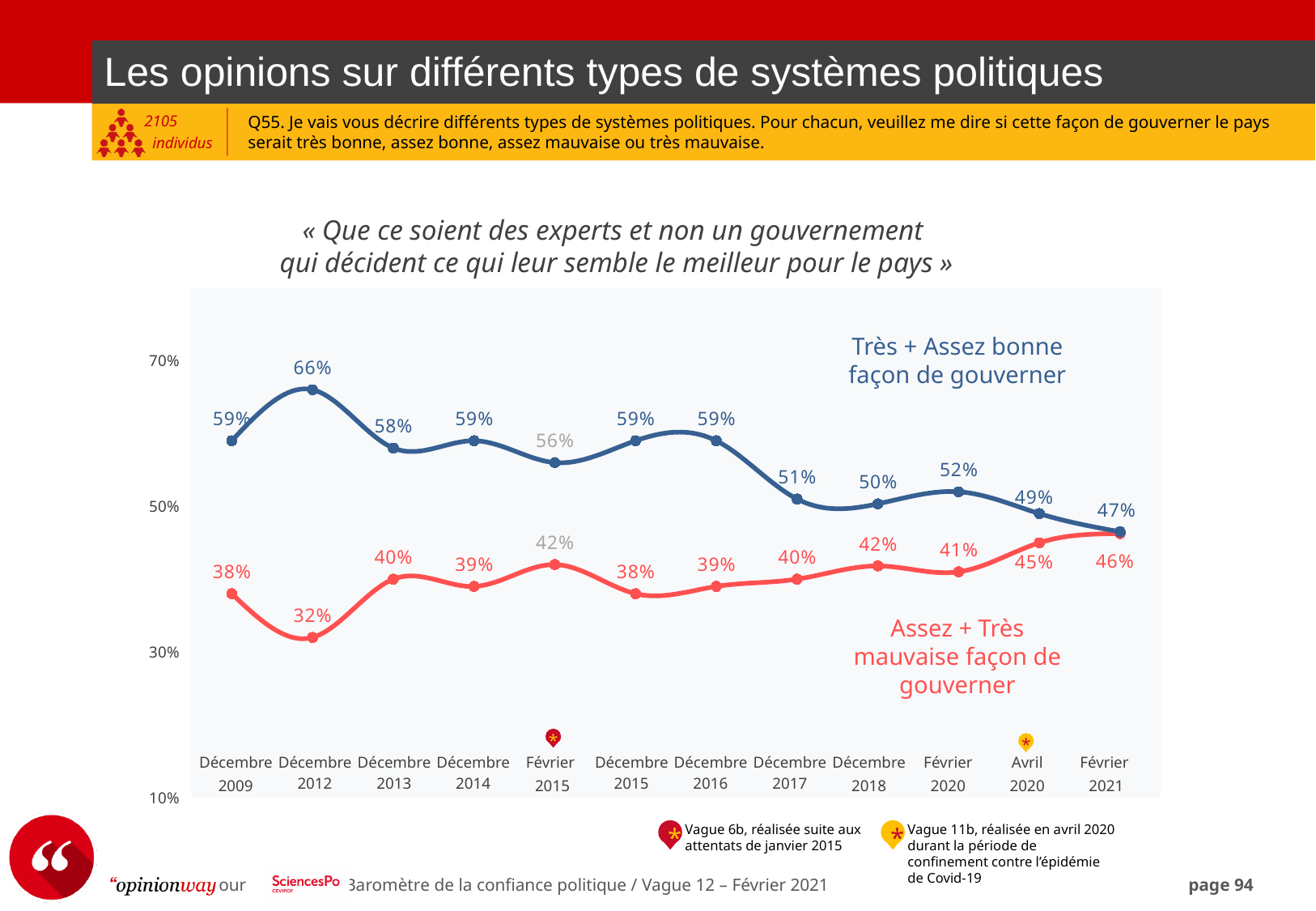
How many series are plotted on the chart? 2 In which period does the 'Assez + Très mauvaise façon de gouverner' series reach its lowest value? Décembre 2012 Which is larger in Avril 2020: the 'Très + Assez bonne' value or the 'Assez + Très mauvaise' value? Très + Assez bonne (49%) In which period does the 'Très + Assez bonne façon de gouverner' series reach its highest value? Décembre 2012 Does the 'Très + Assez bonne façon de gouverner' series rise or fall between Décembre 2016 and Février 2021? fall What is the value of the 'Assez + Très mauvaise façon de gouverner' series in Février 2021? 46% What is the value of the 'Très + Assez bonne façon de gouverner' series in Décembre 2012? 66% What type of chart is shown on the slide? line chart What is the difference between the 'Très + Assez bonne' value and the 'Assez + Très mauvaise' value in Décembre 2009? 21 percentage points What is the value of the 'Assez + Très mauvaise façon de gouverner' series in Décembre 2018? 42% How many time points are plotted on the x axis? 12 What is the value of the 'Très + Assez bonne façon de gouverner' series in Février 2015? 56%